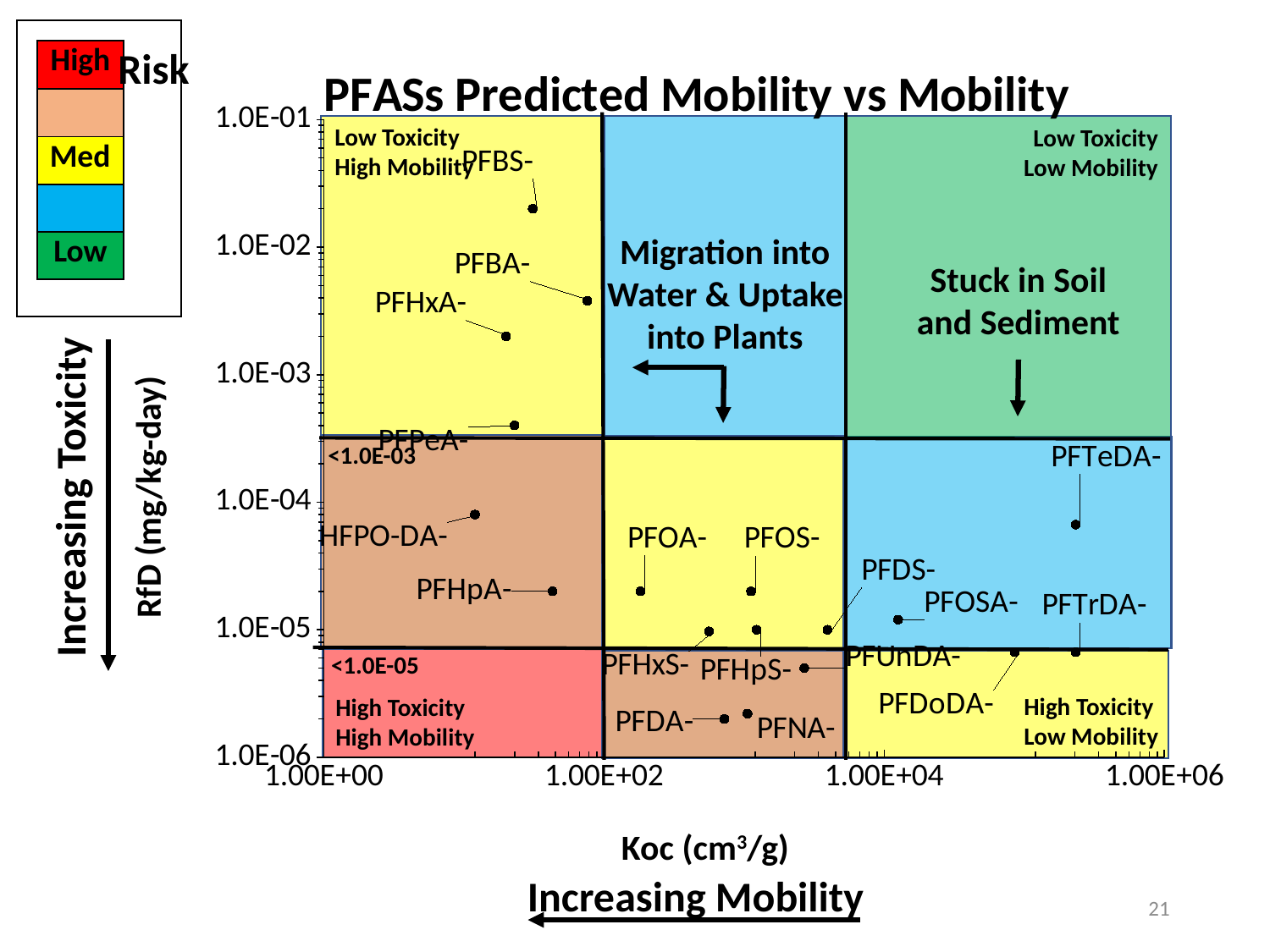
Which compound has the highest RfD value on the chart? PFBS How many labelled compounds are plotted on the chart? 18 Which has a higher RfD value, PFBS or PFNA? PFBS What is the title of the chart? PFASs Predicted Mobility vs Mobility What is the label of the x axis of the chart? Koc (cm³/g) Is the Koc value for PFHxA greater or less than 1.00E+02? less Is the Koc value for PFTeDA greater or less than 1.00E+04? greater Is the RfD value for PFDA greater or less than 1.0E-05? less What kind of chart is shown on the slide? scatter plot Which has a higher Koc value, PFTeDA or PFOA? PFTeDA